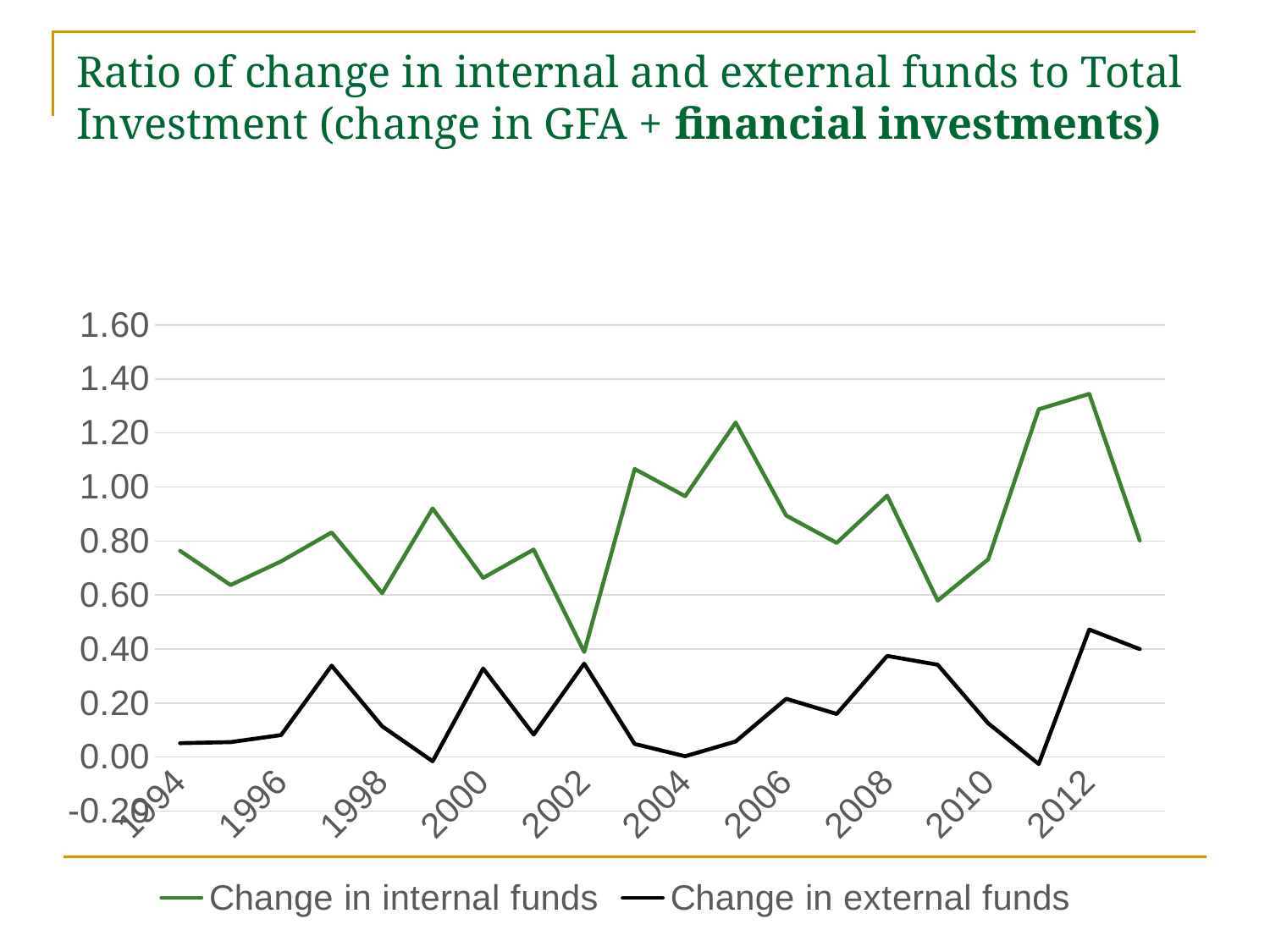
How many series does the legend list? 2 Is the value for Change in external funds in 2004 greater or less than 0.20? less Is the value for Change in internal funds in 1998 greater or less than 0.40? greater Does the Change in external funds series rise or fall from 2008 to 2011? fall In which year does the Change in external funds series reach its highest value? 2012 Which series is drawn in green? Change in internal funds Which series has the highest value in 2012, Change in internal funds or Change in external funds? Change in internal funds Is the value for Change in internal funds in 2012 greater or less than 1.20? greater In which year does the Change in internal funds series reach its lowest value? 2002 What kind of chart is shown on the slide? Line chart Does the Change in internal funds series rise or fall from 2009 to 2012? rise